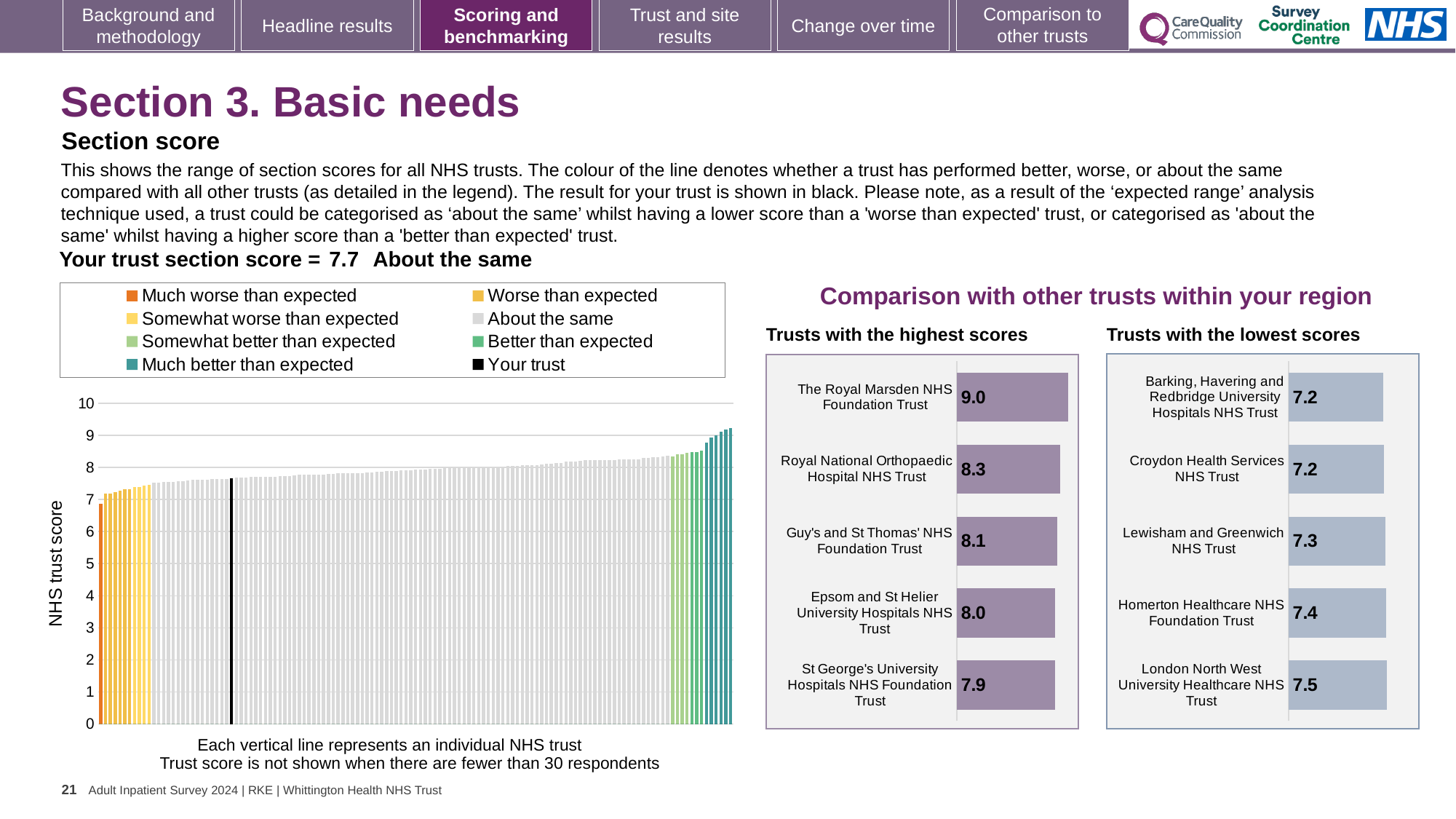
On the 'Trusts with the highest scores' chart, what is the score for Guy's and St Thomas' NHS Foundation Trust? 8.1 On the 'Trusts with the lowest scores' chart, which trust has the highest score? London North West University Healthcare NHS Trust On the 'Trusts with the lowest scores' chart, what is the score for Homerton Healthcare NHS Foundation Trust? 7.4 On the 'Trusts with the highest scores' chart, what is the difference between the scores of The Royal Marsden NHS Foundation Trust and St George's University Hospitals NHS Foundation Trust? 1.1 On the main chart on the left showing all NHS trusts, do the bar values rise or fall from left to right? rise On the main chart on the left showing all NHS trusts, is the value for the black 'Your trust' bar greater or less than 8? less On the 'Trusts with the highest scores' chart, what is the score for The Royal Marsden NHS Foundation Trust? 9.0 On the main chart on the left showing all NHS trusts, how many entries does the legend list? 8 On the 'Trusts with the lowest scores' chart, which has the larger score: Homerton Healthcare NHS Foundation Trust or Lewisham and Greenwich NHS Trust? Homerton Healthcare NHS Foundation Trust On the 'Trusts with the highest scores' chart, which trust has the lowest score? St George's University Hospitals NHS Foundation Trust What kind of chart is the main chart on the left showing all NHS trusts? bar chart On the 'Trusts with the highest scores' chart, how many trusts are shown? 5